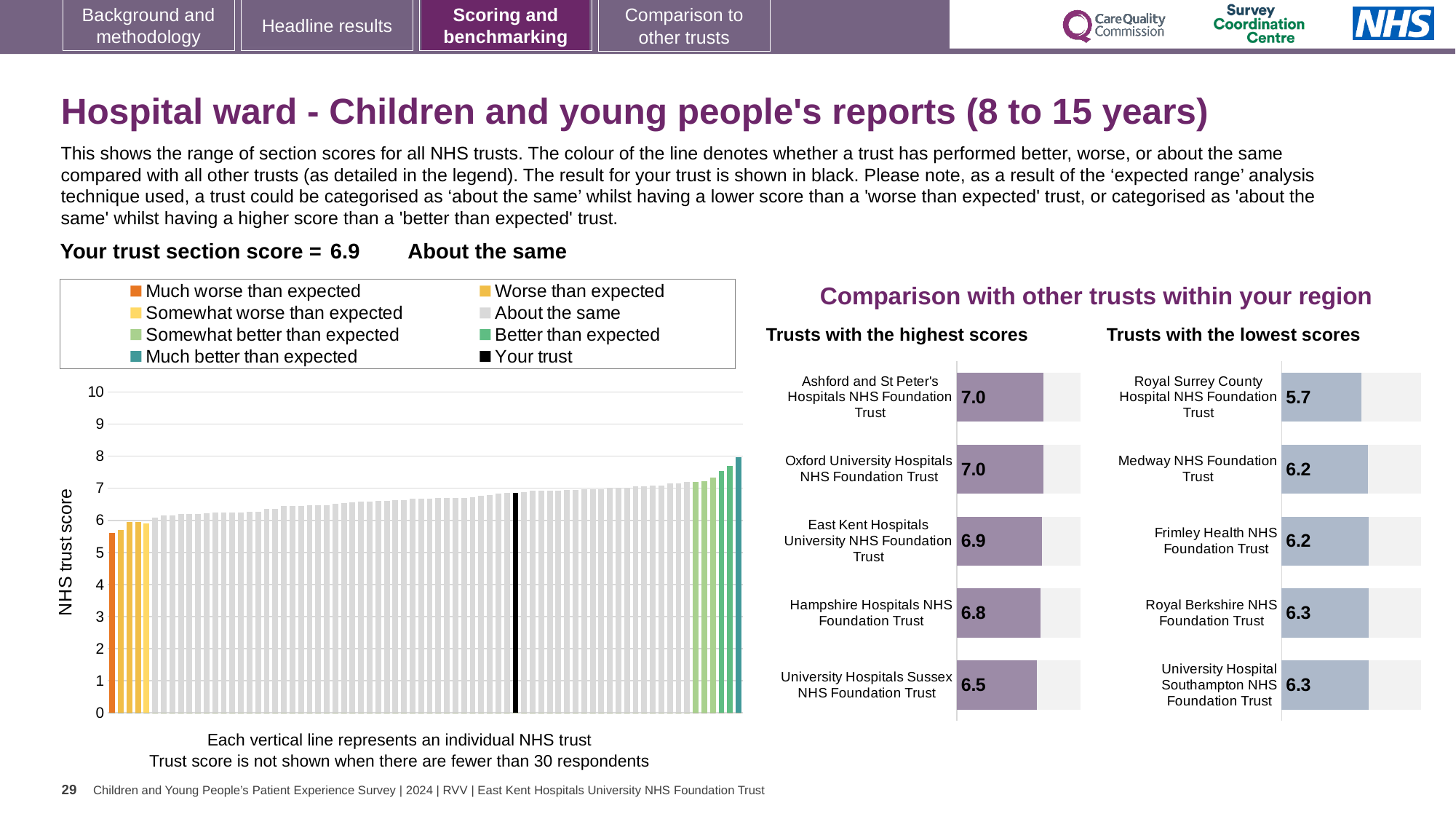
In the 'Trusts with the highest scores' chart, what is the difference between the scores of Ashford and St Peter's Hospitals NHS Foundation Trust and University Hospitals Sussex NHS Foundation Trust? 0.5 In the 'Trusts with the lowest scores' chart, what is the score for Medway NHS Foundation Trust? 6.2 In the 'Trusts with the lowest scores' chart, what is the difference between the scores of Royal Berkshire NHS Foundation Trust and Royal Surrey County Hospital NHS Foundation Trust? 0.6 In the large chart on the left showing all NHS trusts, is the value of the tallest bar greater or less than 7? greater In the 'Trusts with the highest scores' chart, which trust has the lowest score? University Hospitals Sussex NHS Foundation Trust In the large chart on the left showing all NHS trusts, how many entries does the legend list? 8 Which has the higher score: Hampshire Hospitals NHS Foundation Trust in the highest-scores chart or Frimley Health NHS Foundation Trust in the lowest-scores chart? Hampshire Hospitals NHS Foundation Trust In the 'Trusts with the highest scores' chart, what is the score for Hampshire Hospitals NHS Foundation Trust? 6.8 What type of chart is the large chart on the left showing all NHS trusts? Bar chart In the 'Trusts with the lowest scores' chart, which trust has the lowest score? Royal Surrey County Hospital NHS Foundation Trust In the 'Trusts with the highest scores' chart, what is the score for Ashford and St Peter's Hospitals NHS Foundation Trust? 7.0 How many trusts are shown in the 'Trusts with the lowest scores' chart? 5